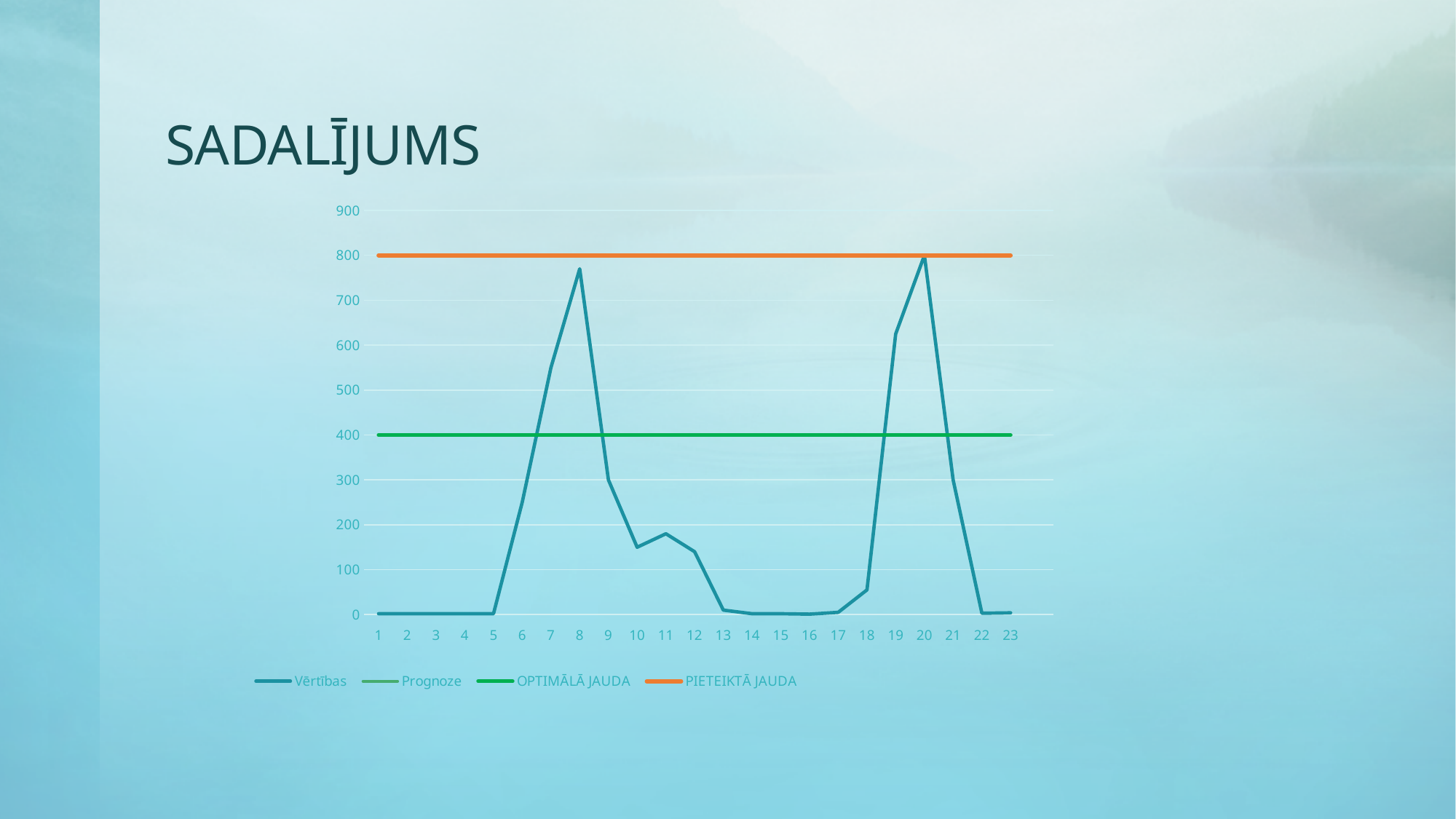
What is the difference between the PIETEIKTĀ JAUDA line and the OPTIMĀLĀ JAUDA line? 400 Which is larger, OPTIMĀLĀ JAUDA or PIETEIKTĀ JAUDA? PIETEIKTĀ JAUDA What kind of chart is shown on the slide? line chart What is the value of the PIETEIKTĀ JAUDA line? 800 Does the Vērtības line rise or fall from point 5 to point 8? rise Is the Vērtības value at point 8 greater or less than 700? greater What is the value of the OPTIMĀLĀ JAUDA line? 400 Which is higher for Vērtības, point 8 or point 19? point 8 Is the Vērtības value at point 9 greater or less than 400? less How many series does the legend list? 4 How many points are on the x axis of the chart? 23 Is the Vērtības value at point 11 greater or less than 100? greater